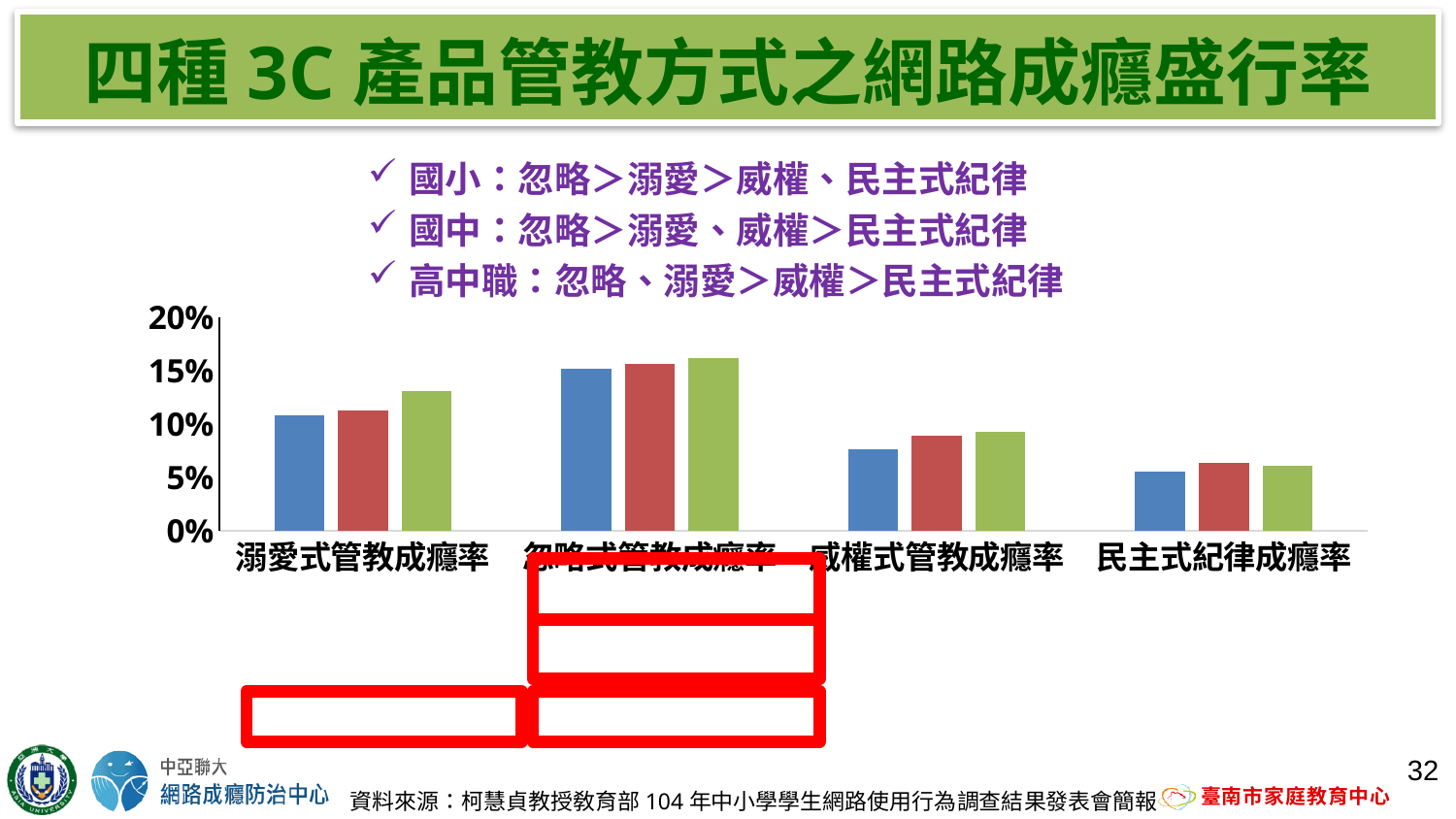
What is the highest tick value shown on the y axis of the chart? 20% Is the value of the blue bar for 威權式管教成癮率 greater or less than 10%? less How many bars are plotted for each category in the chart? 3 Which is larger: the green bar for 溺愛式管教成癮率 or the green bar for 威權式管教成癮率? 溺愛式管教成癮率 How many categories are shown on the x axis of the chart? 4 Is the value of the blue bar for 溺愛式管教成癮率 greater or less than 10%? greater Is the value of the green bar for 民主式紀律成癮率 greater or less than 10%? less Which category has the shortest bars in the chart? 民主式紀律成癮率 Which category has the tallest bars in the chart? 忽略式管教成癮率 What kind of chart is shown on the slide? bar chart